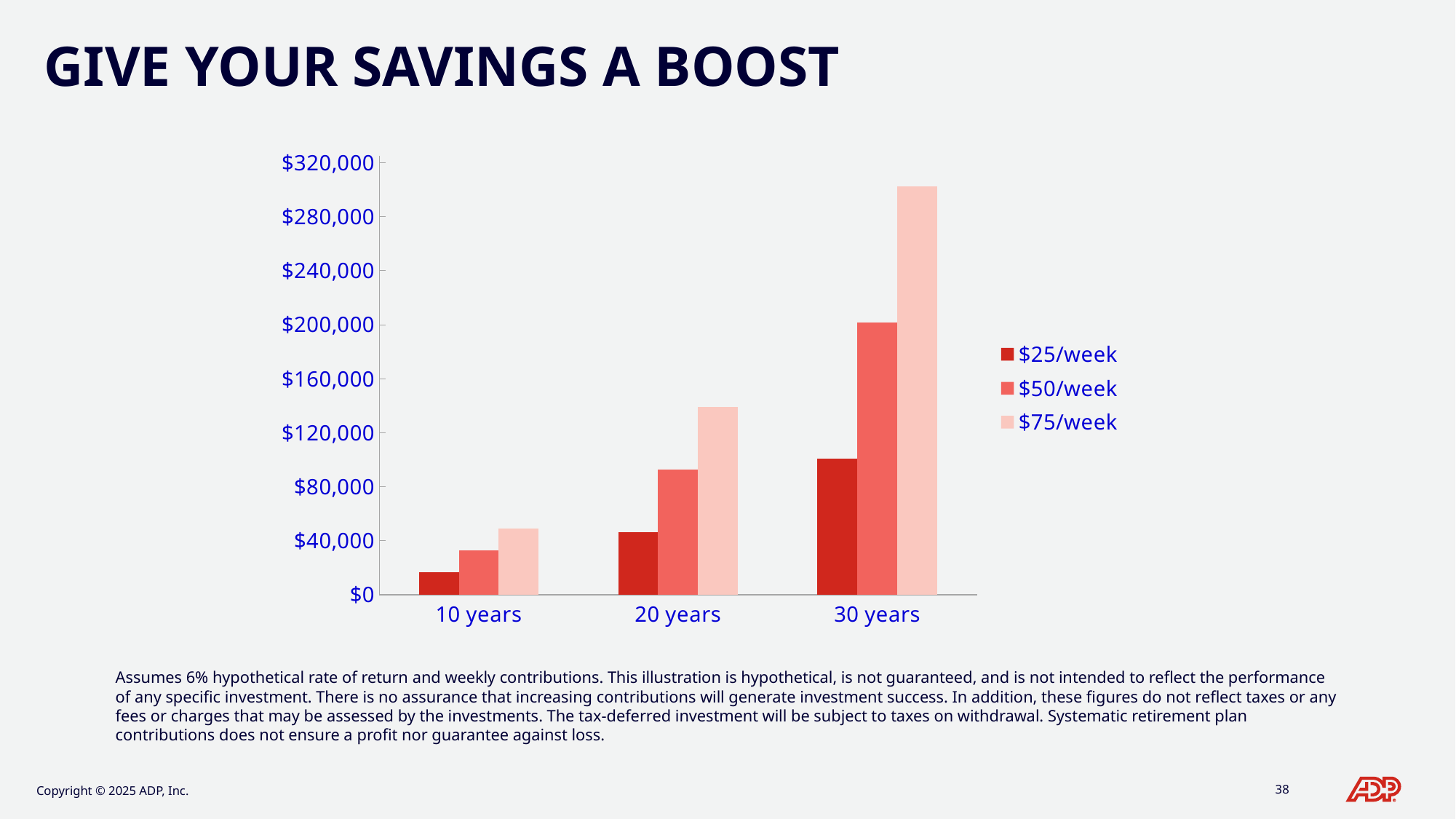
Which series has the tallest bar at 30 years? $75/week What is the title of the slide containing the chart? GIVE YOUR SAVINGS A BOOST How many time-period categories are shown on the x axis? 3 Do the values for $50/week rise or fall as the number of years increases? rise Is the value for $25/week at 10 years greater or less than $40,000? less Is the value for $75/week at 30 years greater or less than $280,000? greater Which is larger: the $50/week value at 20 years or the $25/week value at 30 years? $25/week at 30 years Is the value for $25/week at 30 years greater or less than $80,000? greater Which series has the shortest bar at 10 years? $25/week How many series does the legend list? 3 What kind of chart is shown on the slide? bar chart